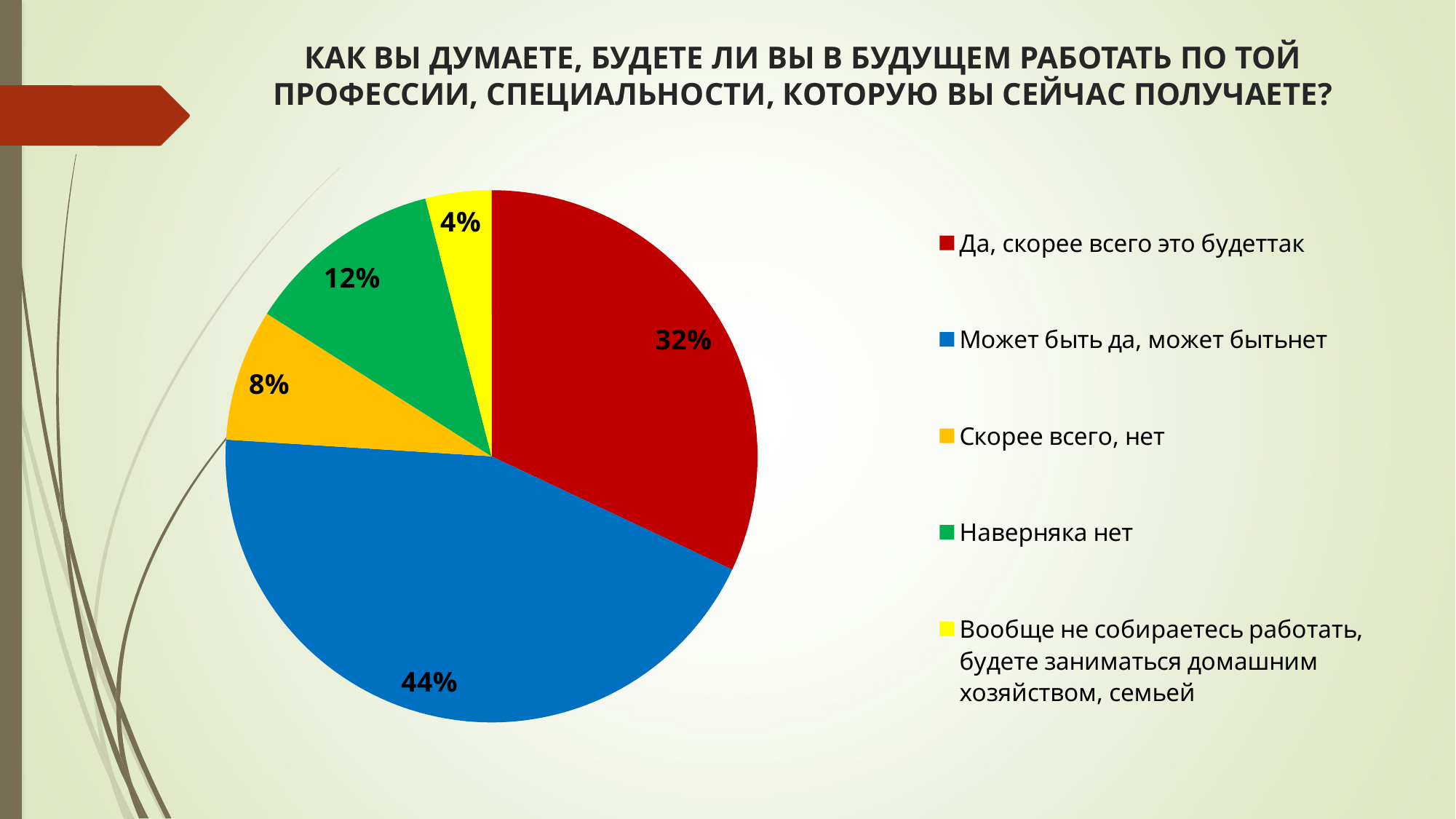
What percentage of respondents answered "Может быть да, может быть нет"? 44% How many answer options (slices) does the pie chart show? 5 What kind of chart is shown on the slide? pie chart What percentage of respondents answered "Наверняка нет"? 12% What percentage of respondents answered "Да, скорее всего это будет так"? 32% Which answer option has the smallest share of the pie? Вообще не собираетесь работать, будете заниматься домашним хозяйством, семьей Which answer option has the largest share of the pie? Может быть да, может быть нет What colour is the slice for "Скорее всего, нет"? orange Which is larger: the share for "Наверняка нет" or the share for "Скорее всего, нет"? Наверняка нет What percentage of respondents answered "Скорее всего, нет"? 8% What percentage of respondents answered "Вообще не собираетесь работать, будете заниматься домашним хозяйством, семьей"? 4% What is the difference in percentage points between "Может быть да, может быть нет" and "Да, скорее всего это будет так"? 12